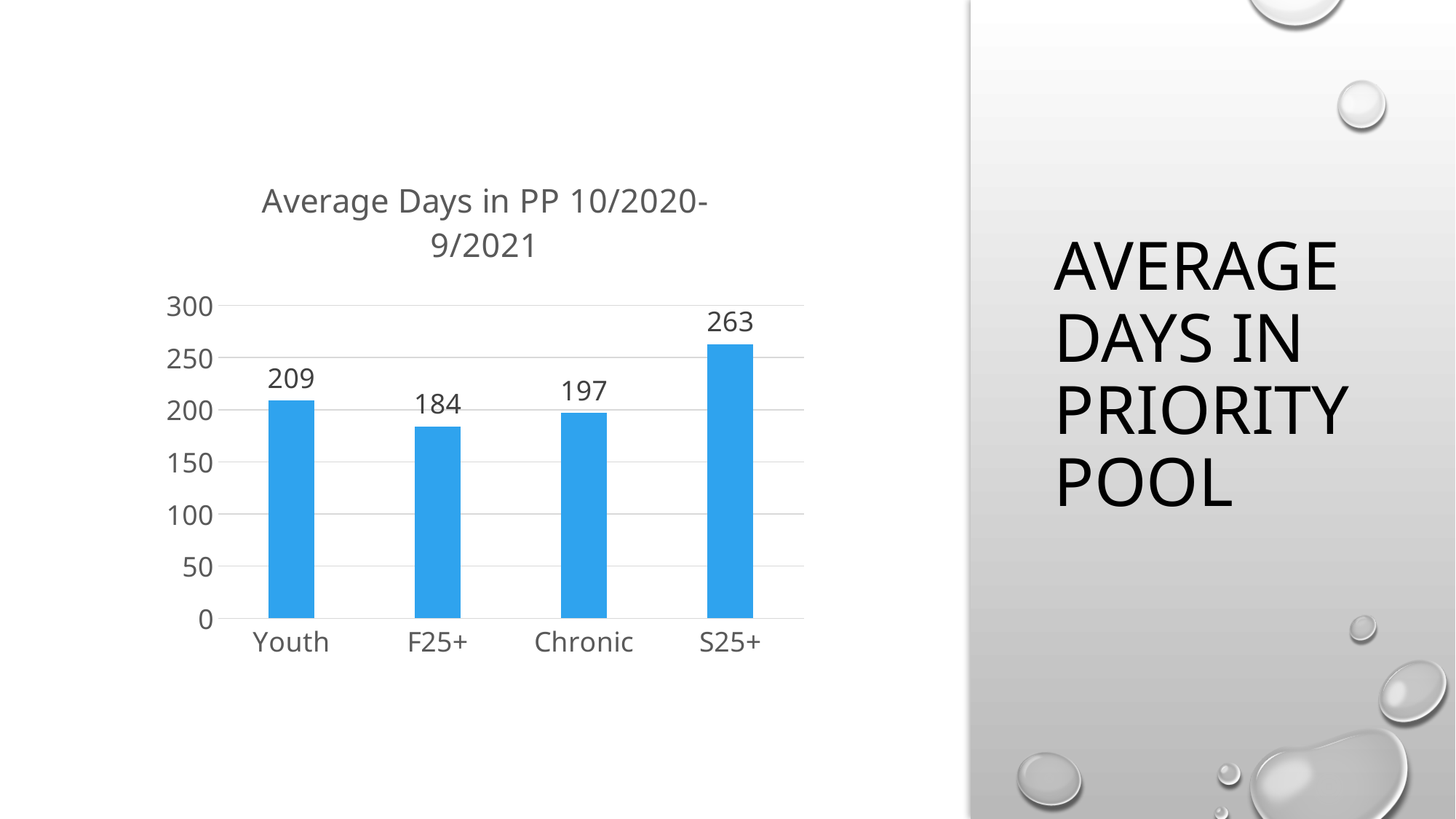
How many categories are shown in the chart? 4 What is the difference in average days between S25+ and F25+? 79 What type of chart is shown on the slide? Bar chart What is the average days in PP for Chronic? 197 Is the value for S25+ greater or less than 250? greater What is the difference in average days between Youth and Chronic? 12 Which category has the lowest average days in PP? F25+ Which has more average days in PP, Youth or Chronic? Youth What is the average days in PP for Youth? 209 What is the average days in PP for S25+? 263 Which category has the highest average days in PP? S25+ What is the average days in PP for F25+? 184